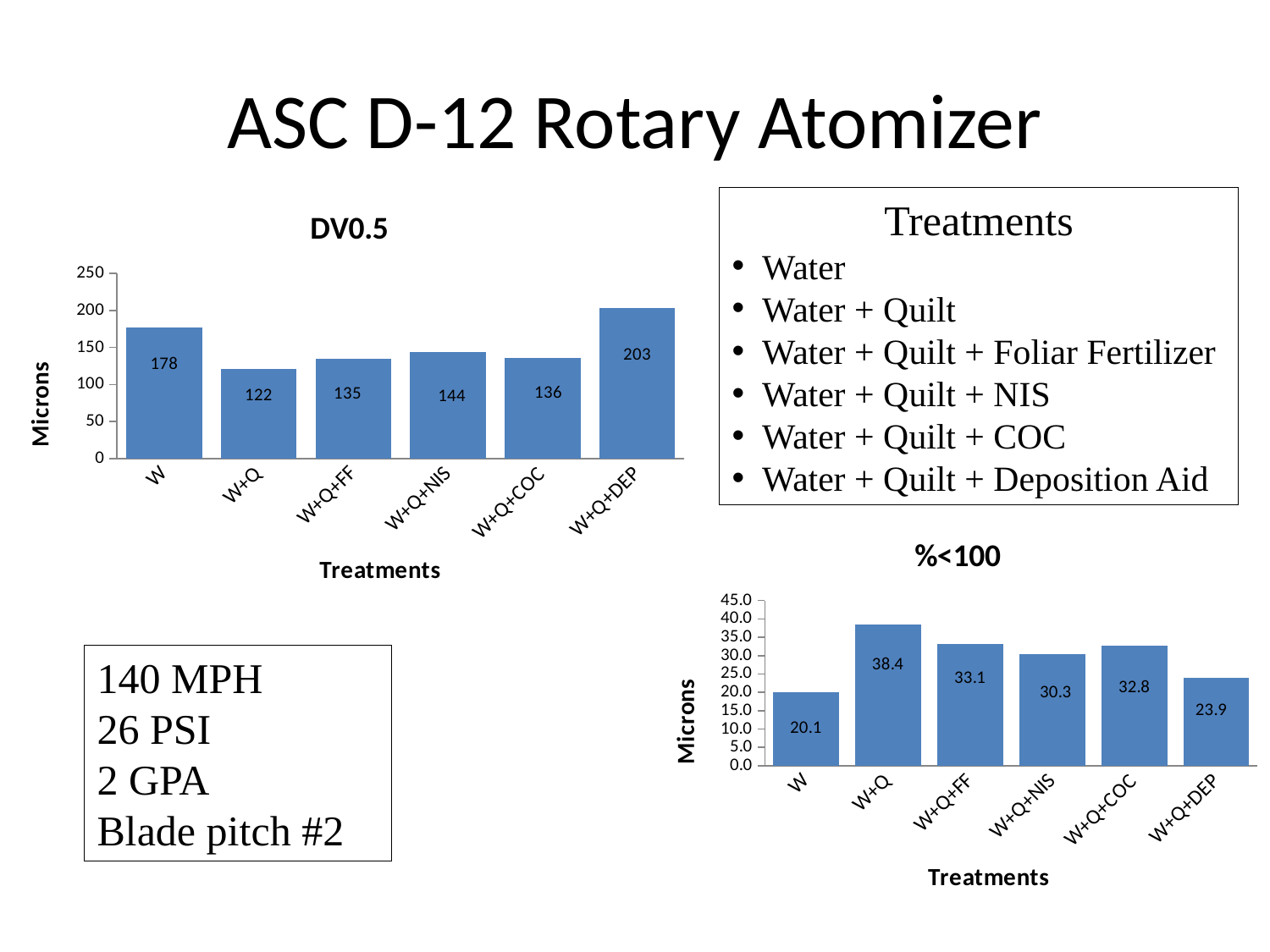
In the DV0.5 chart, what is the value for W+Q+DEP? 203 In the DV0.5 chart, how many treatments are plotted? 6 In the DV0.5 chart, which treatment has the lowest value? W+Q In the %<100 chart, which treatment has the highest value? W+Q In the %<100 chart, what is the difference between the values for W+Q and W+Q+DEP? 14.5 In the %<100 chart, what is the value for W+Q? 38.4 In the %<100 chart, which is larger, the value for W+Q+FF or the value for W+Q+NIS? W+Q+FF What kind of chart is the DV0.5 chart? Bar chart In the %<100 chart, which treatment has the lowest value? W In the DV0.5 chart, which treatment has the highest value? W+Q+DEP What is the y-axis label of the %<100 chart? Microns In the DV0.5 chart, what is the difference between the values for W and W+Q? 56